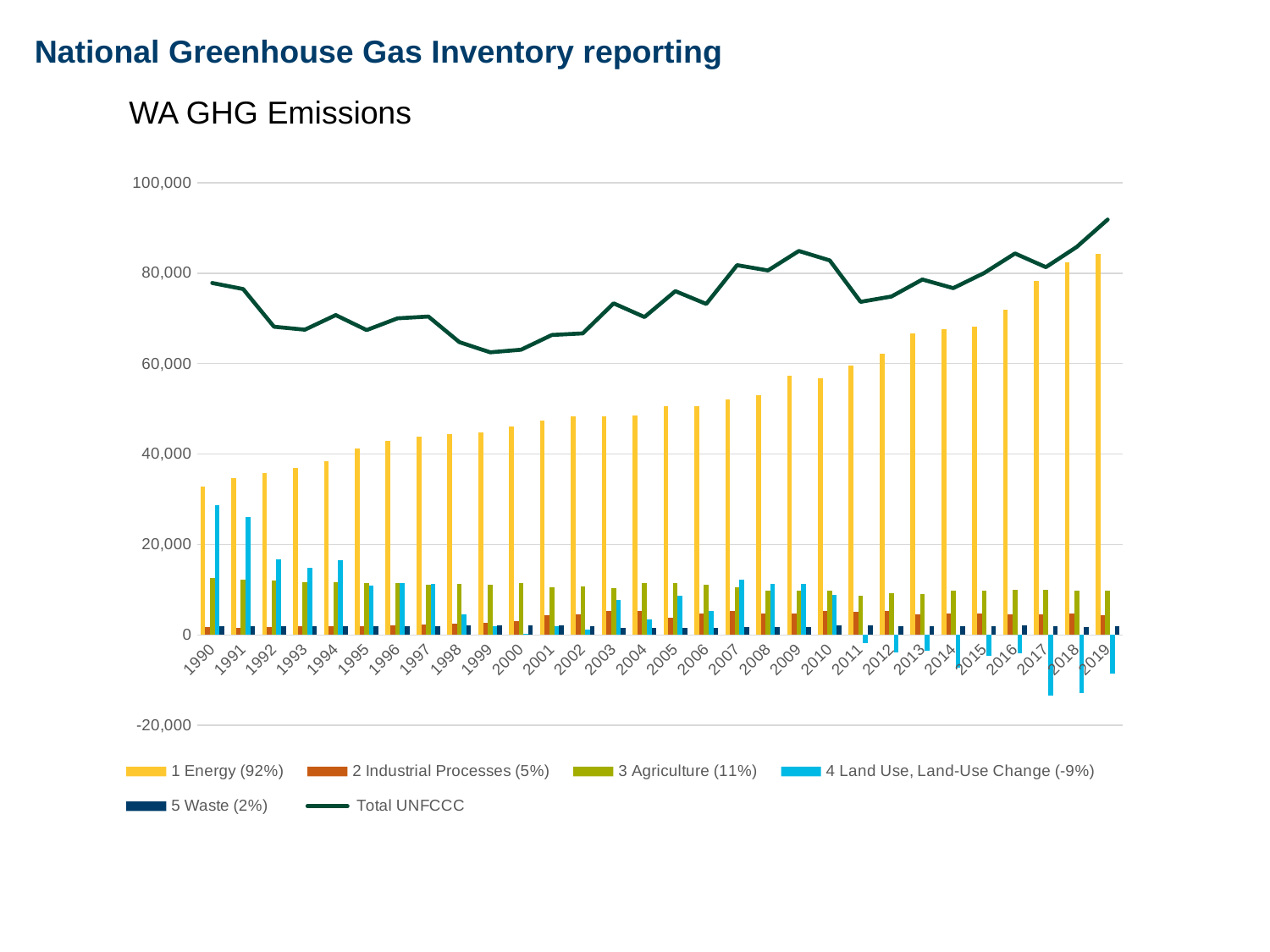
Is the value for 1 Energy in 2019 greater or less than 80,000? greater How many years are shown on the x axis of the WA GHG Emissions chart? 30 Is the value for 1 Energy in 1990 greater or less than 40,000? less In which year is the 1 Energy bar lowest? 1990 Is the Total UNFCCC value in 2019 greater or less than 80,000? greater In which year is the 1 Energy bar highest? 2019 Which series is plotted as a line rather than bars? Total UNFCCC Do the 1 Energy bars generally rise or fall from 1990 to 2019? rise Which is larger, the Total UNFCCC value in 1990 or in 2019? 2019 What kind of chart is shown on the slide? bar chart with a line How many series does the legend of the WA GHG Emissions chart list? 6